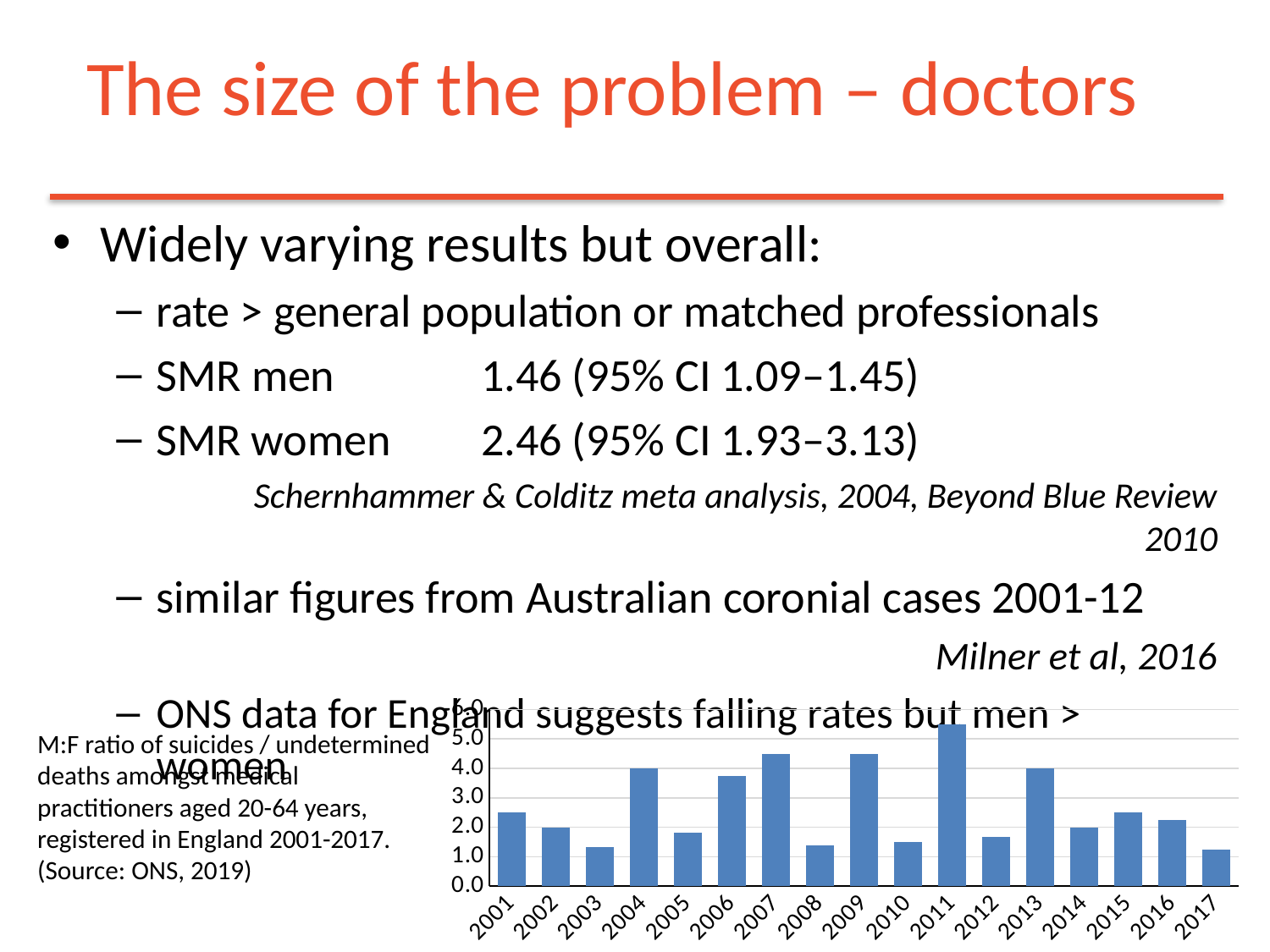
Which is larger, the value for 2007 or the value for 2008? 2007 Is the value for 2008 greater or less than 2.0? less What is the first year shown on the x axis of the chart? 2001 Which is larger, the value for 2004 or the value for 2005? 2004 Is the value for 2006 greater or less than 4.0? less Is the value for 2013 greater or less than 3.0? greater What is the highest tick value shown on the y axis of the chart? 6.0 Which year has the highest bar in the chart? 2011 How many years are plotted on the x axis of the bar chart? 17 What kind of chart is shown at the bottom of the slide? bar chart